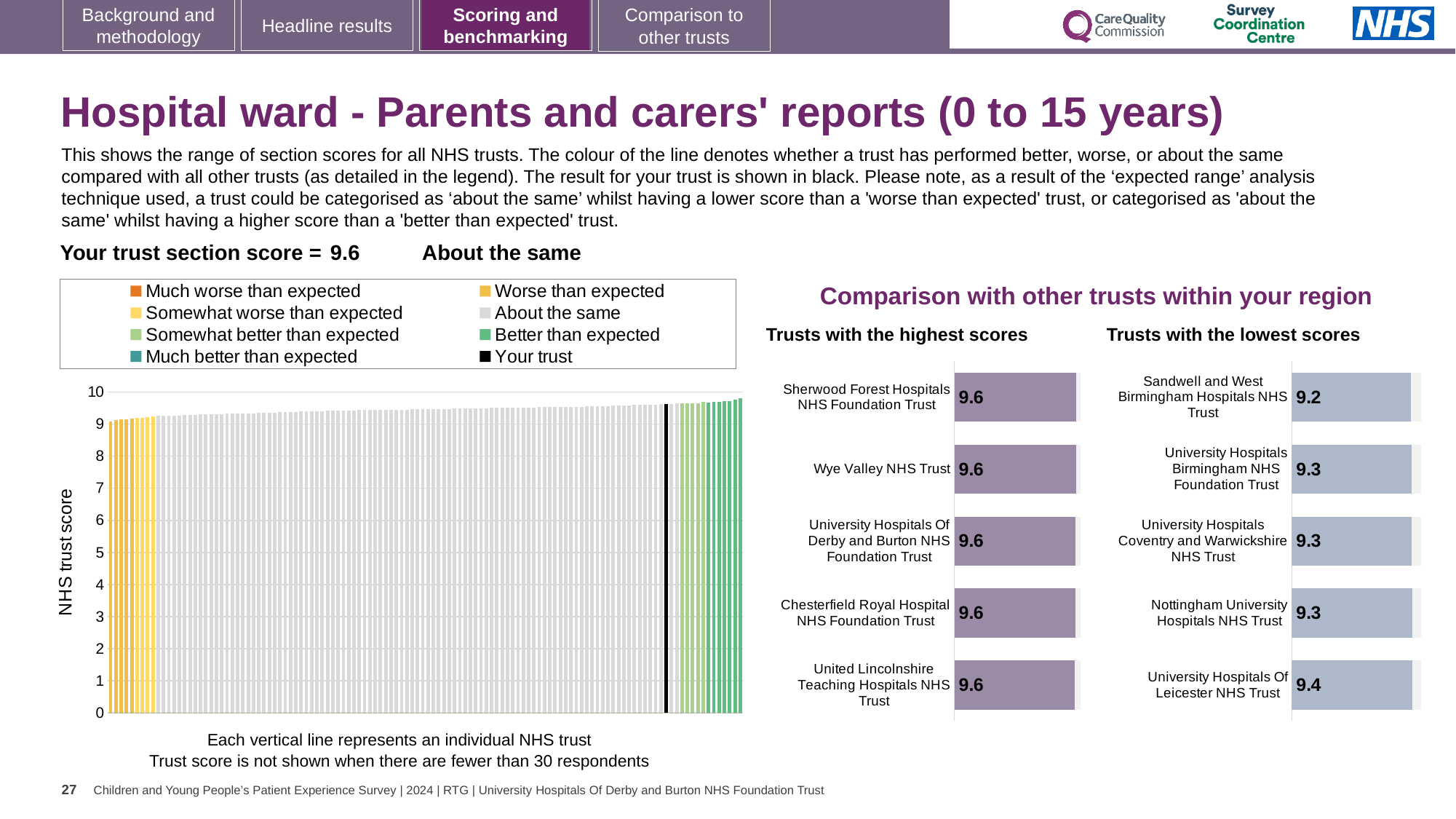
In the 'Trusts with the lowest scores' chart, what is the value for Sandwell and West Birmingham Hospitals NHS Trust? 9.2 In the large chart on the left, do the bar values rise or fall from left to right? rise What kind of chart is the large chart on the left with the y axis labelled 'NHS trust score'? bar chart In the 'Trusts with the lowest scores' chart, which has the larger score: Nottingham University Hospitals NHS Trust or University Hospitals Of Leicester NHS Trust? University Hospitals Of Leicester NHS Trust In the large chart on the left, is the value of the black bar (your trust) greater or less than 9? greater In the 'Trusts with the lowest scores' chart, what is the difference between the scores of University Hospitals Of Leicester NHS Trust and Sandwell and West Birmingham Hospitals NHS Trust? 0.2 In the 'Trusts with the lowest scores' chart, which trust has the lowest score? Sandwell and West Birmingham Hospitals NHS Trust In the 'Trusts with the highest scores' chart, what is the value for Sherwood Forest Hospitals NHS Foundation Trust? 9.6 In the 'Trusts with the lowest scores' chart, which trust has the highest score? University Hospitals Of Leicester NHS Trust In the large chart on the left, how many entries does the legend list? 8 In the large chart on the left, what is the label on the y axis? NHS trust score In the 'Trusts with the highest scores' chart, how many trusts are shown? 5